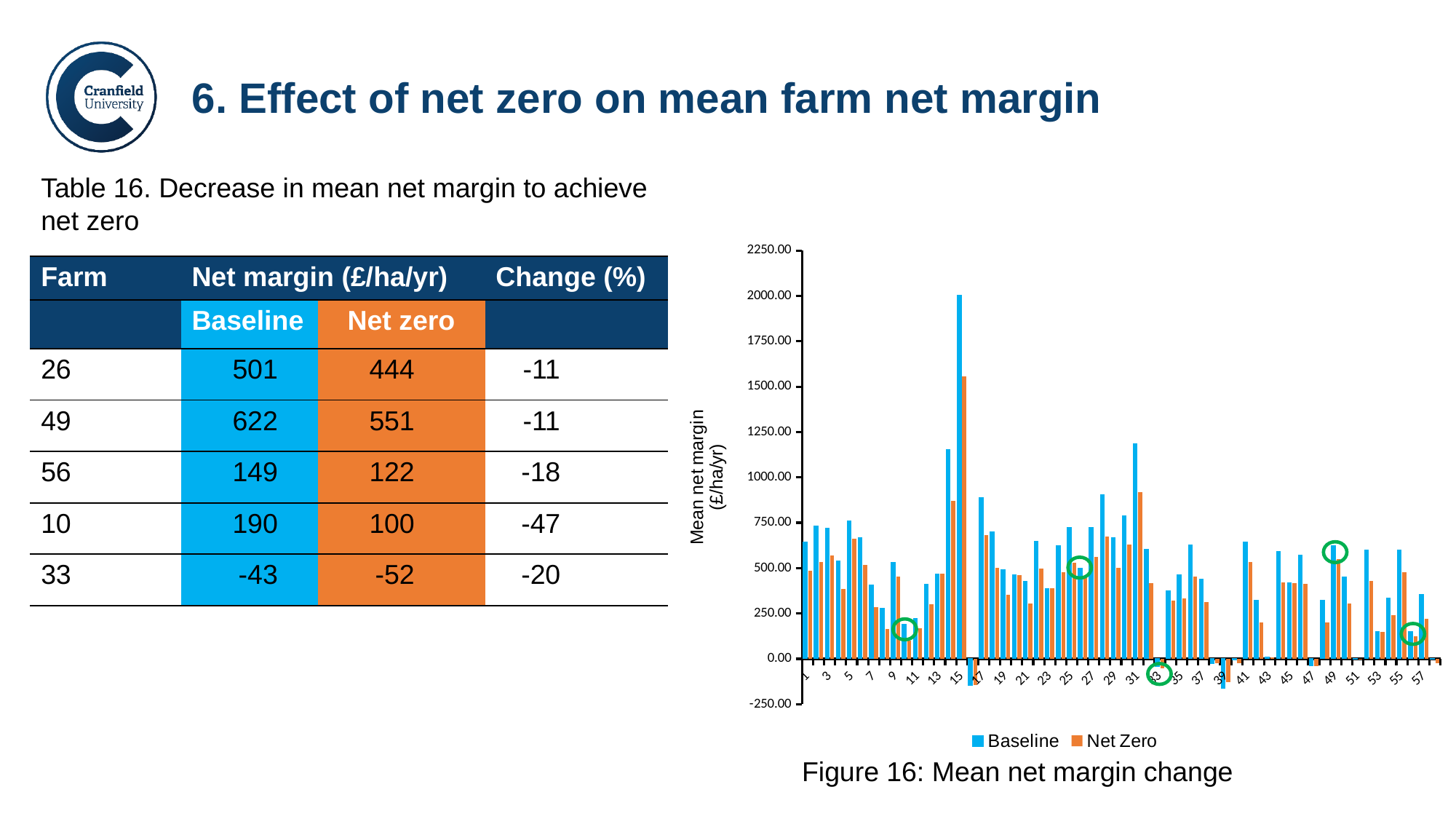
What is the y-axis label of Figure 16? Mean net margin (£/ha/yr) How many series does the legend of Figure 16 list? 2 In Figure 16, is the Baseline value for farm 9 greater or less than 750.00? less In Figure 16, which farm has the highest Baseline mean net margin? 15 In Figure 16, is the Baseline value for farm 31 greater or less than 1000.00? greater In Figure 16, is the Baseline value for farm 15 greater or less than 1750.00? greater In Figure 16, which is larger for farm 15: the Baseline value or the Net Zero value? Baseline In Figure 16, which farm has the larger Baseline value: farm 15 or farm 31? 15 In Figure 16, which farm has the highest Net Zero mean net margin? 15 What are the two series named in the legend of Figure 16? Baseline and Net Zero What kind of chart is Figure 16? bar chart